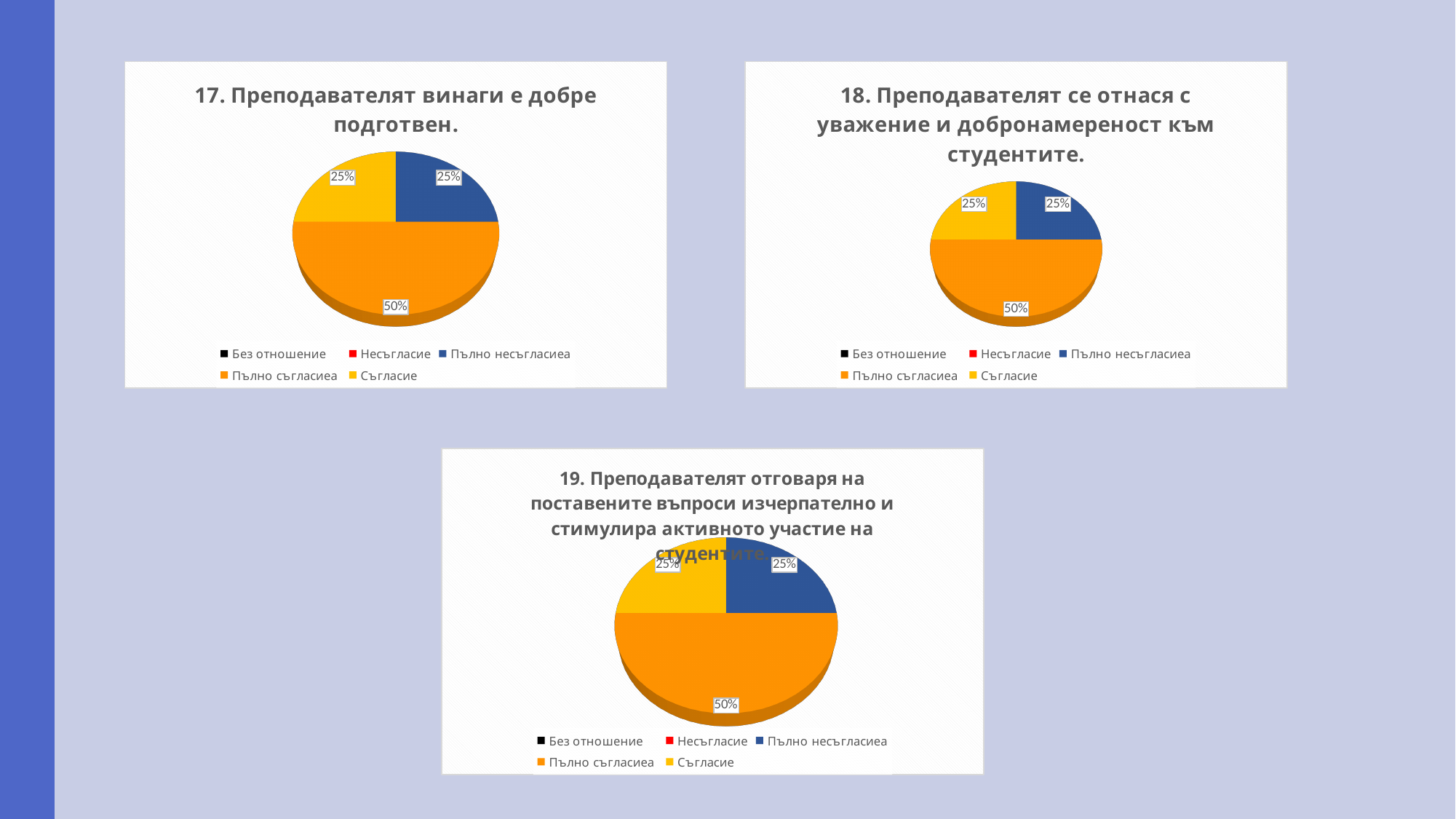
In the chart titled "17. Преподавателят винаги е добре подготвен.", what is the difference between the share for "Пълно съгласиеа" and the share for "Пълно несъгласиеа"? 25% In the chart titled "17. Преподавателят винаги е добре подготвен.", what share does "Съгласие" have? 25% How many entries does the legend of the bottom chart (question 19) list? 5 How many slices are visible in the pie of the chart titled "17. Преподавателят винаги е добре подготвен."? 3 In the chart titled "18. Преподавателят се отнася с уважение и добронамереност към студентите.", what colour is the slice for "Съгласие"? Yellow In the bottom chart (question 19), what share does "Пълно съгласиеа" have? 50% In the bottom chart (question 19), which is larger: the slice for "Пълно съгласиеа" or the slice for "Съгласие"? Пълно съгласиеа In the chart titled "18. Преподавателят се отнася с уважение и добронамереност към студентите.", which category has the largest slice? Пълно съгласиеа What type of chart is the chart titled "18. Преподавателят се отнася с уважение и добронамереност към студентите."? Pie chart In the chart titled "18. Преподавателят се отнася с уважение и добронамереност към студентите.", what share does "Пълно несъгласиеа" have? 25% How many charts are shown on the slide? 3 In the chart titled "17. Преподавателят винаги е добре подготвен.", what share does "Пълно съгласиеа" have? 50%